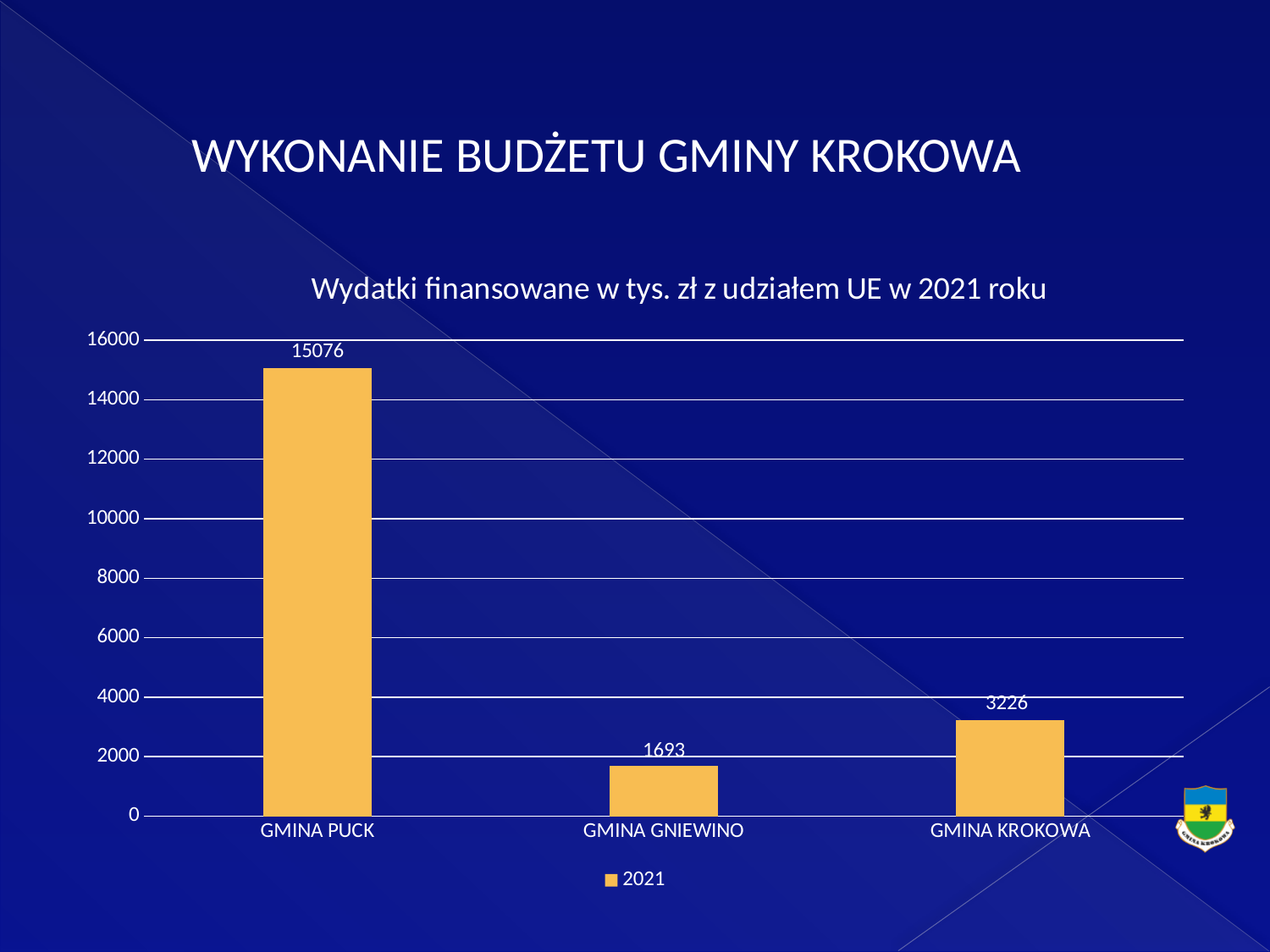
How many series does the legend list? 1 What is the difference between the values for GMINA PUCK and GMINA KROKOWA? 11850 Which category has the lowest value? GMINA GNIEWINO What kind of chart is shown on the slide? bar chart What is the value for GMINA GNIEWINO? 1693 What is the value for GMINA KROKOWA? 3226 Which is larger, the value for GMINA KROKOWA or GMINA GNIEWINO? GMINA KROKOWA How many categories are shown on the chart? 3 Is the value for GMINA KROKOWA greater or less than 4000? less Which category has the highest value? GMINA PUCK What is the value for GMINA PUCK? 15076 What is the difference between the values for GMINA KROKOWA and GMINA GNIEWINO? 1533